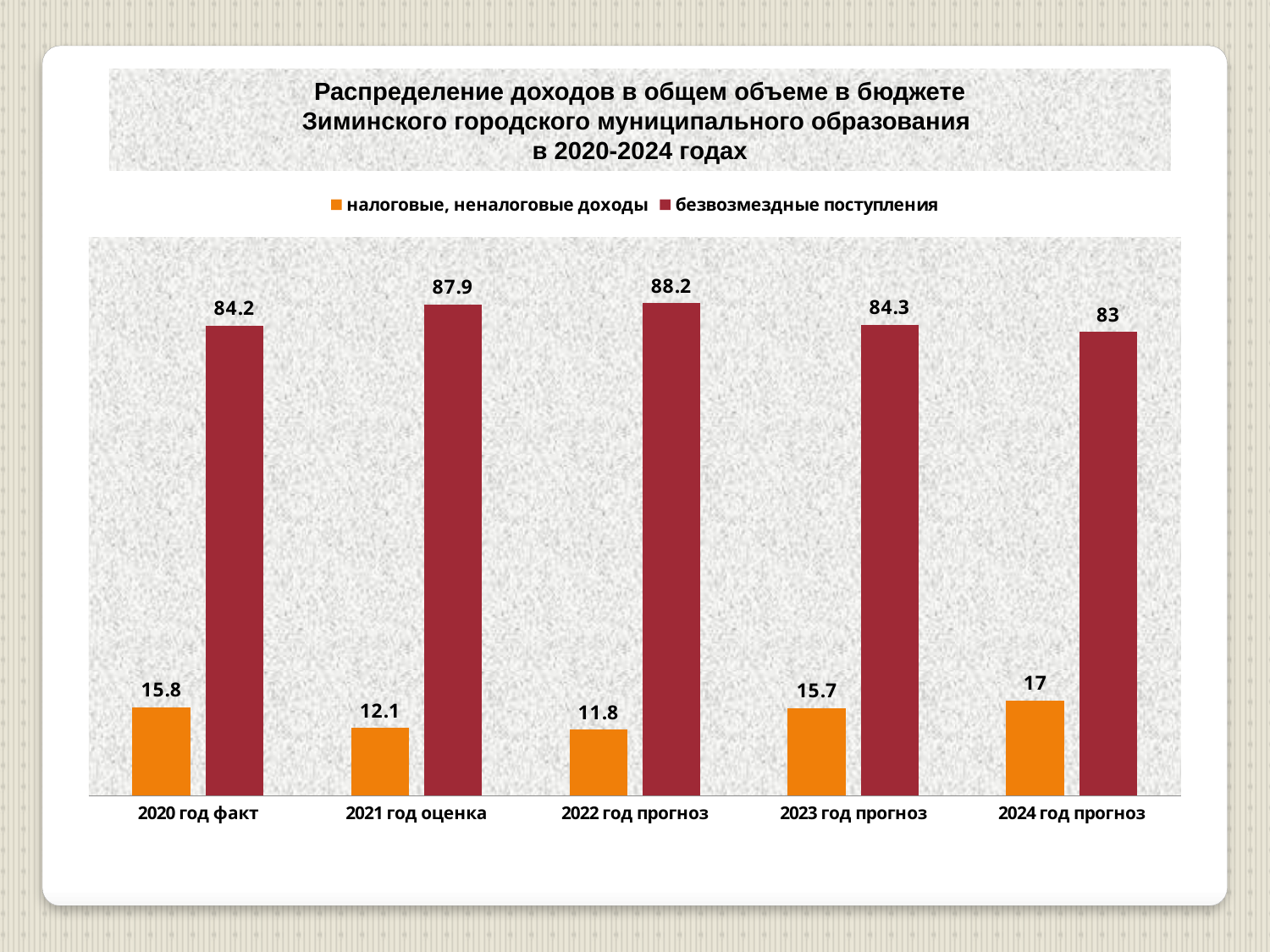
How many series does the legend list? 2 Does безвозмездные поступления rise or fall from 2022 год прогноз to 2024 год прогноз? fall In which year is безвозмездные поступления highest? 2022 год прогноз What is the value of налоговые, неналоговые доходы for 2024 год прогноз? 17 In which year is налоговые, неналоговые доходы lowest? 2022 год прогноз What is the value of налоговые, неналоговые доходы for 2020 год факт? 15.8 Which colour represents безвозмездные поступления in the legend? dark red How many year categories are shown on the x axis? 5 What is the value of безвозмездные поступления for 2022 год прогноз? 88.2 Which is larger: налоговые, неналоговые доходы for 2020 год факт or for 2023 год прогноз? 2020 год факт What is the difference between безвозмездные поступления and налоговые, неналоговые доходы for 2021 год оценка? 75.8 What kind of chart is shown on the slide? bar chart